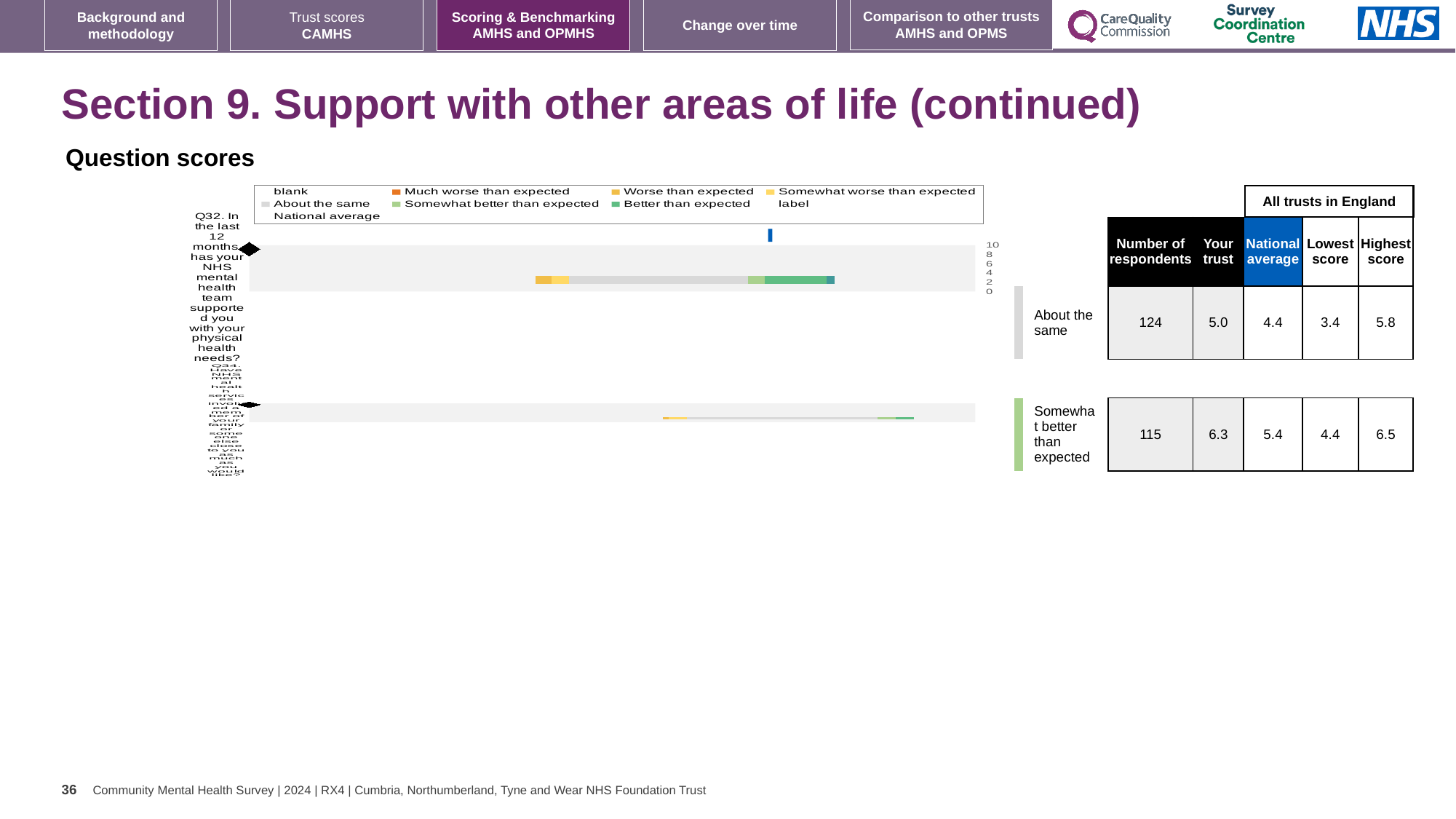
What is the highest score among all trusts in England for Q34? 6.5 For Q32, which is larger: the 'Your trust' score or the national average? Your trust Which benchmark category is Q32 placed in? About the same For Q34, what is the difference between the 'Your trust' score and the national average? 0.9 For Q32, what is the difference between the highest and lowest scores among all trusts in England? 2.4 What is the national average score for Q34 (involving family or someone close)? 5.4 How many survey questions are plotted in the question scores chart? 2 What is the 'Your trust' score for Q32 (support with physical health needs)? 5.0 What is the lowest score among all trusts in England for Q32? 3.4 Which benchmark category is Q34 placed in? Somewhat better than expected What kind of chart is used to show the question scores on this slide? Bar chart How many respondents answered Q32? 124